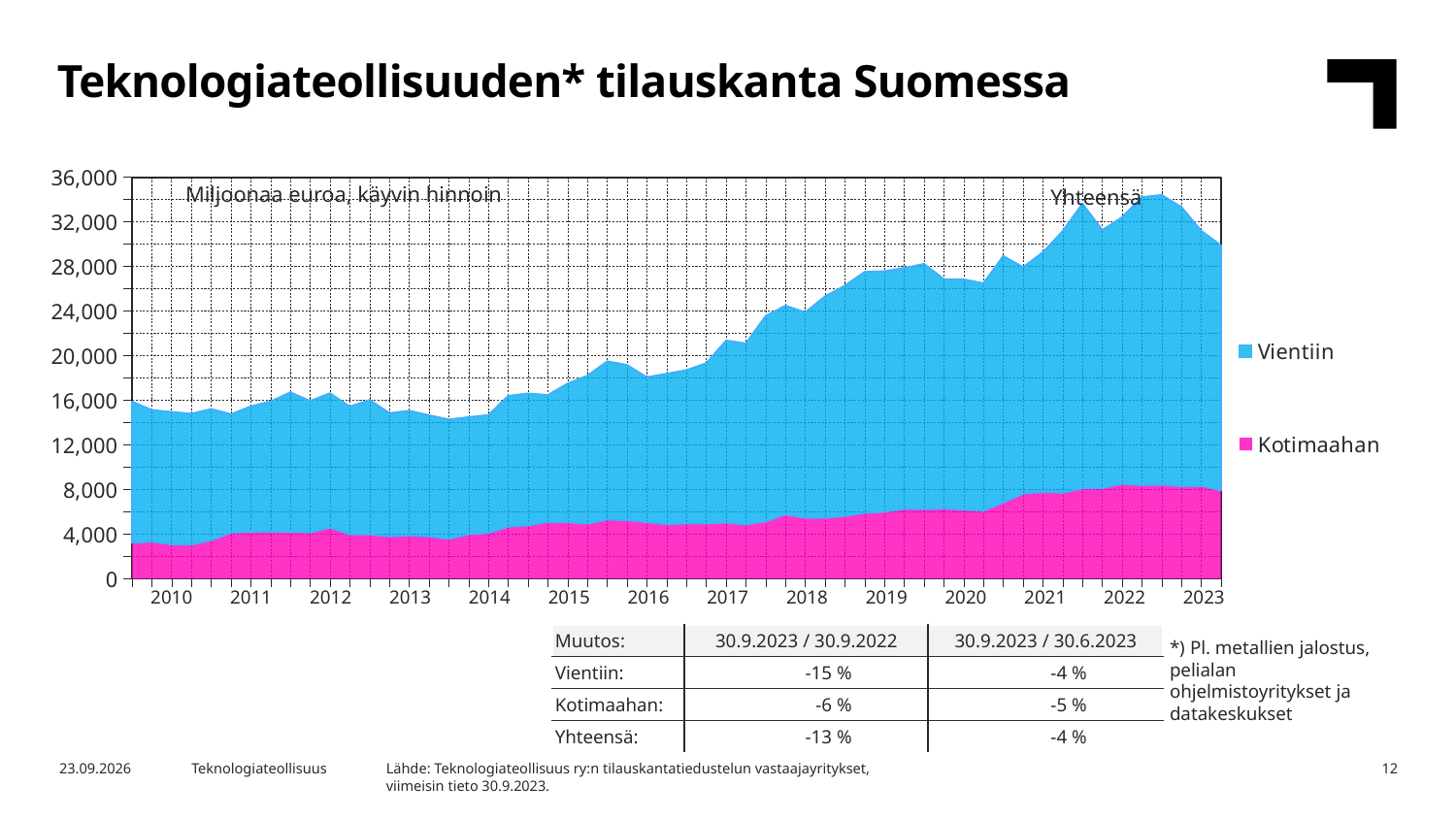
Does the Kotimaahan series generally rise or fall from 2010 to 2023? rise What are the two series named in the chart legend? Vientiin and Kotimaahan Is the Kotimaahan value at the start of 2016 greater or less than 4,000? greater Is the total (Yhteensä) value at the start of 2010 greater or less than 16,000? less Is the total (Yhteensä) value at the end of the series in 2023 greater or less than 28,000? greater What unit is stated in the chart's subtitle? Miljoonaa euroa, käyvin hinnoin How many years are labelled on the x axis of the chart? 14 Which series is larger throughout the chart, Vientiin or Kotimaahan? Vientiin What kind of chart is shown on the slide? Stacked area chart How many series does the chart legend list? 2